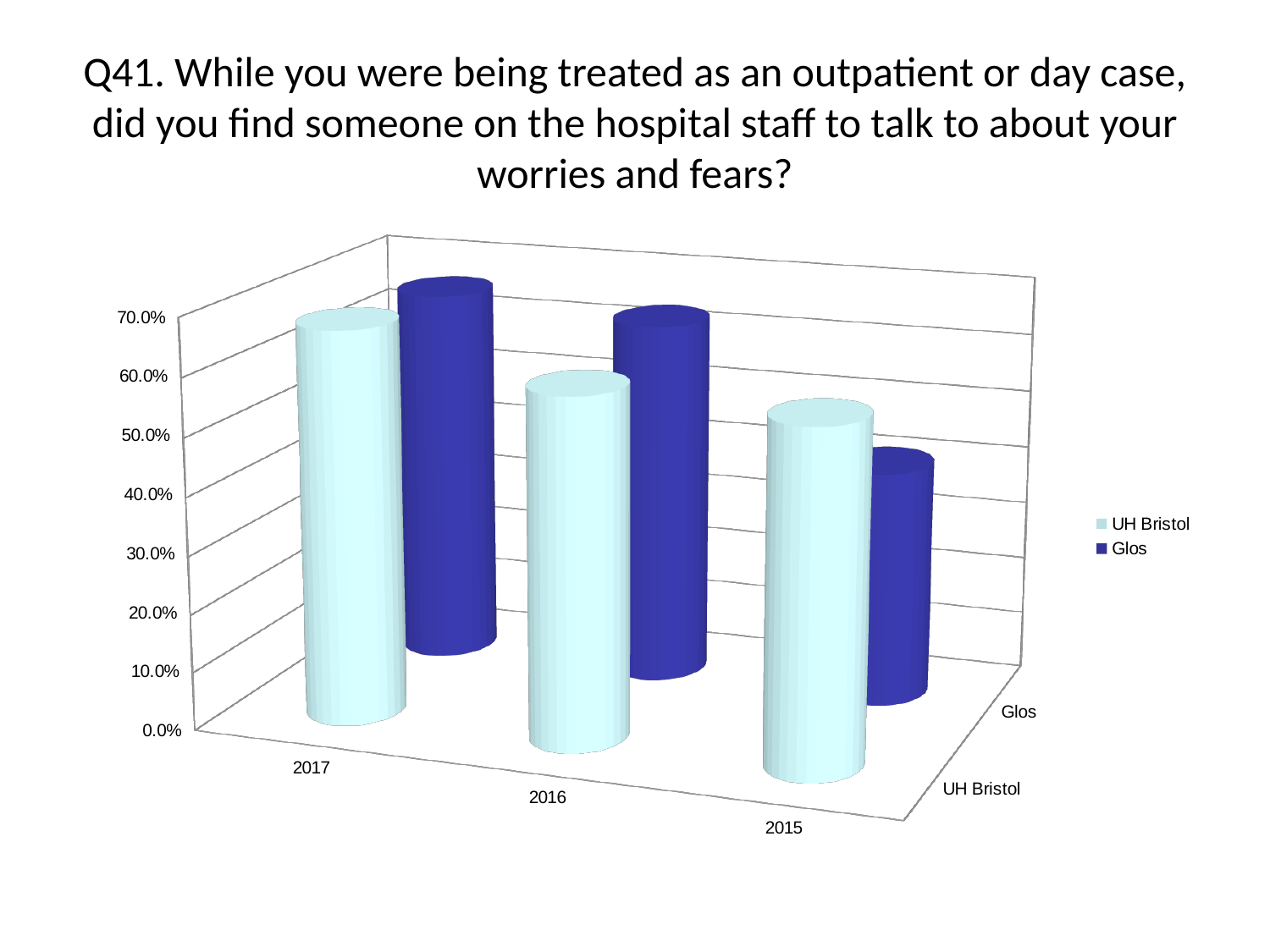
For Glos, which year has the highest value? 2017 How many year categories are shown on the x axis? 3 Is the value for UH Bristol in 2017 greater or less than 50.0%? greater What kind of chart is shown on the slide? bar chart In 2015, which is larger, the value for UH Bristol or the value for Glos? UH Bristol For UH Bristol, which year has the lowest value? 2015 Which series are listed in the legend? UH Bristol and Glos For Glos, which year has the lowest value? 2015 How many series does the legend list? 2 What colour are the Glos bars? dark blue Is the value for Glos in 2015 greater or less than 60.0%? less For UH Bristol, which year has the highest value? 2017